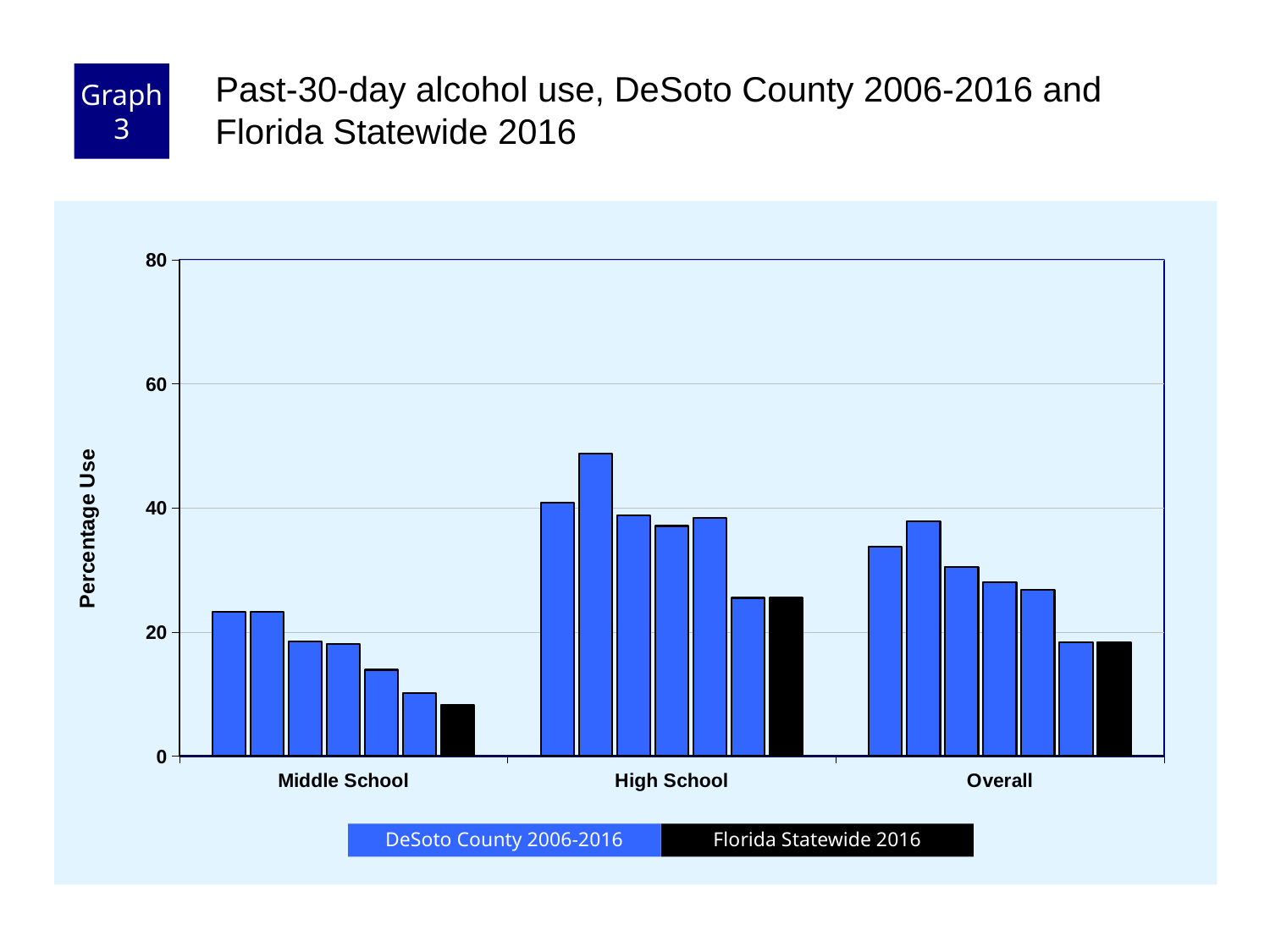
What is the label on the y axis? Percentage Use Which is larger, the Florida Statewide 2016 value for High School or for Middle School? High School Which category group contains the highest bar on the chart? High School How many bars are plotted in the High School group? 7 How many categories are shown on the x axis? 3 Is the tallest DeSoto County 2006-2016 bar in the High School group greater or less than 40? greater How many series does the legend list? 2 Is the Florida Statewide 2016 value for High School greater or less than 20? greater Is the Florida Statewide 2016 value for Middle School greater or less than 20? less Within the Middle School group, do the DeSoto County 2006-2016 bars generally rise or fall from left to right? fall What kind of chart is shown on the slide? bar chart